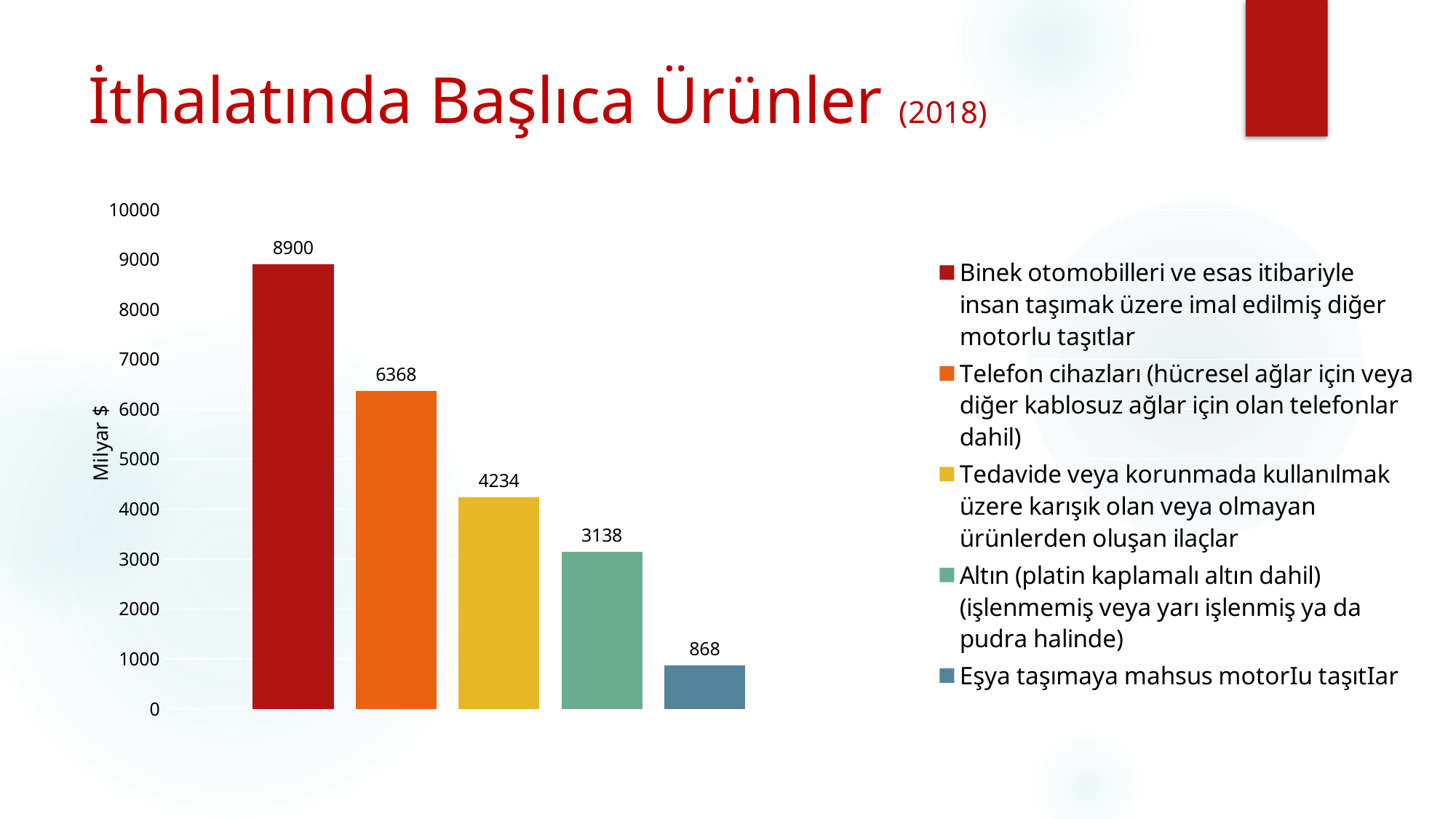
What colour is the bar for Tedavide veya korunmada kullanılmak üzere karışık olan veya olmayan ürünlerden oluşan ilaçlar? Yellow Which is larger: the value for Tedavide veya korunmada kullanılmak üzere karışık olan veya olmayan ürünlerden oluşan ilaçlar or the value for Altın? Tedavide veya korunmada kullanılmak üzere karışık olan veya olmayan ürünlerden oluşan ilaçlar What is the difference between the values for Binek otomobilleri and Telefon cihazları? 2532 What is the label of the vertical axis? Milyar $ How many bars are shown in the chart? 5 What is the value for Eşya taşımaya mahsus motorlu taşıtlar? 868 What is the value for Telefon cihazları (hücresel ağlar için veya diğer kablosuz ağlar için olan telefonlar dahil)? 6368 What is the value for Binek otomobilleri ve esas itibariyle insan taşımak üzere imal edilmiş diğer motorlu taşıtlar? 8900 Which category has the lowest value? Eşya taşımaya mahsus motorlu taşıtlar What kind of chart is shown on the slide? Bar chart Which category has the highest value? Binek otomobilleri ve esas itibariyle insan taşımak üzere imal edilmiş diğer motorlu taşıtlar What is the value for Altın (platin kaplamalı altın dahil) (işlenmemiş veya yarı işlenmiş ya da pudra halinde)? 3138